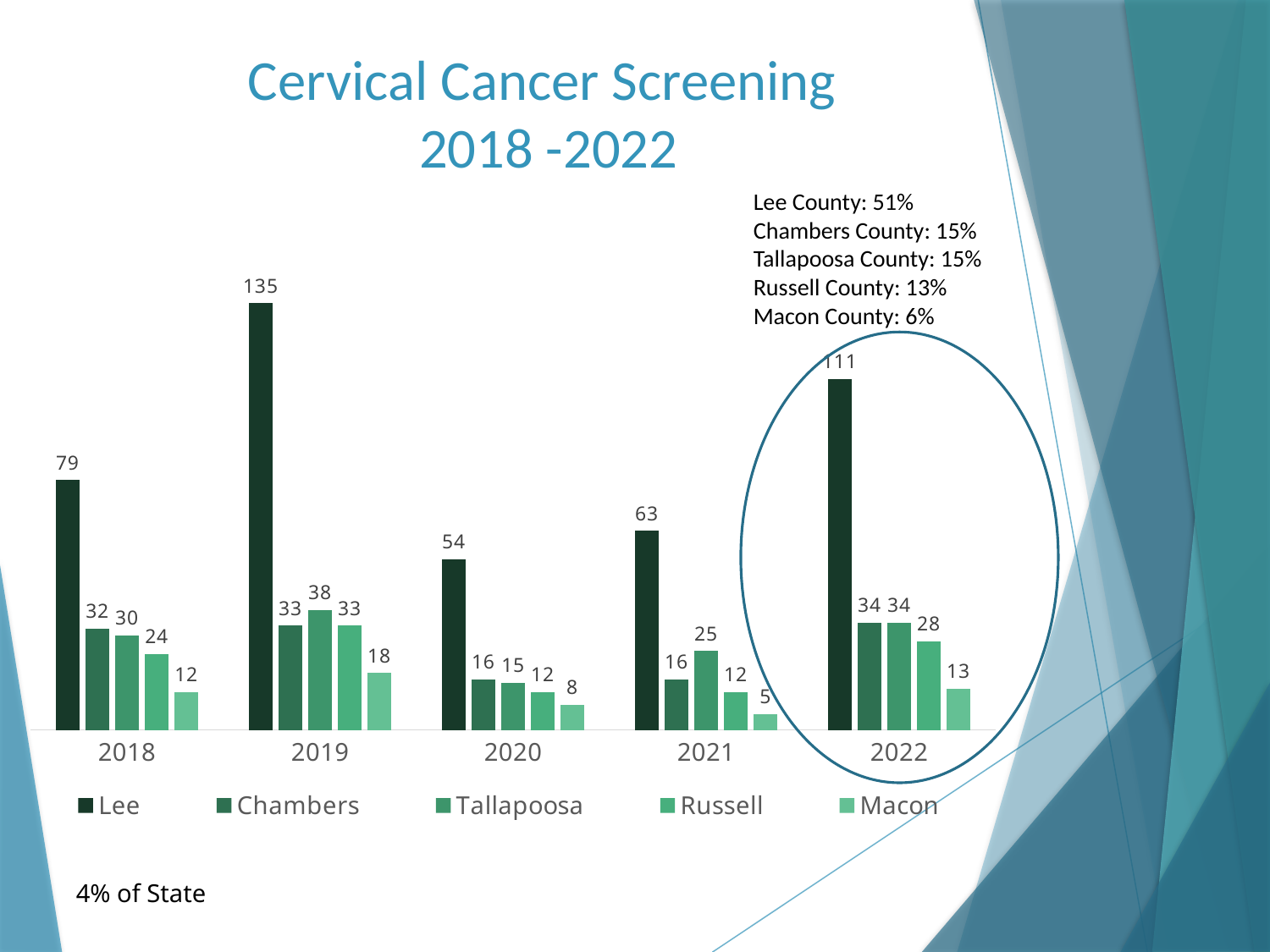
What is the value for Lee in 2019? 135 Do the Lee values rise or fall from 2019 to 2021? fall In which year is the Lee value highest? 2019 How many years are shown on the x axis? 5 How many series does the legend list? 5 What is the title of the chart? Cervical Cancer Screening 2018 -2022 In which year is the Macon value lowest? 2021 What is the value for Macon in 2021? 5 What is the value for Russell in 2022? 28 What kind of chart is shown on the slide? bar chart What is the difference between the Lee values for 2019 and 2020? 81 Which is larger, the Tallapoosa value in 2019 or the Tallapoosa value in 2021? 2019